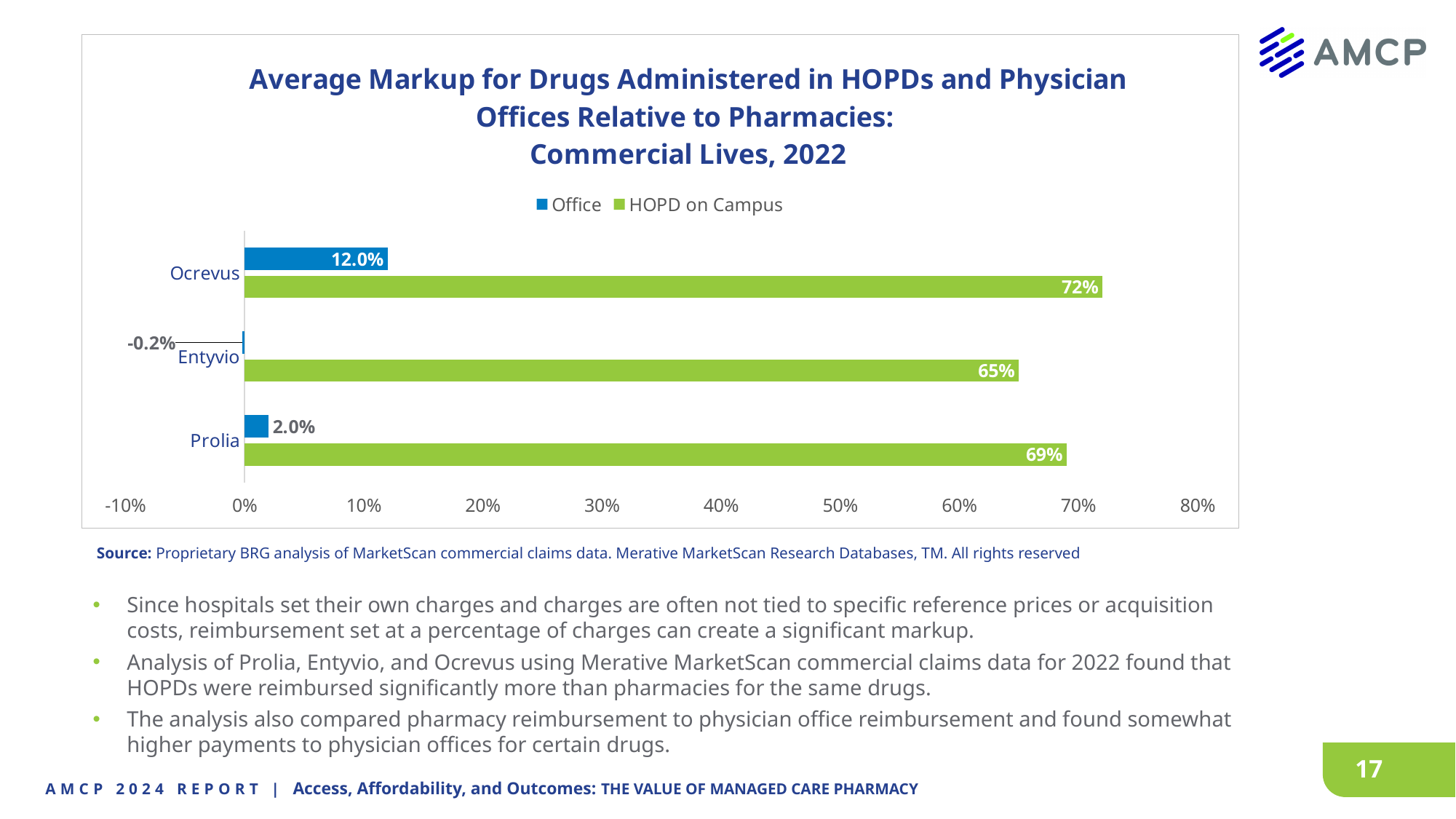
How many series does the legend list? 2 Which is larger for Prolia, the Office markup or the HOPD on Campus markup? HOPD on Campus How many drugs are shown on the chart? 3 What is the HOPD on Campus markup for Ocrevus? 72% Which colour represents the HOPD on Campus series? Green Which drug has the highest HOPD on Campus markup? Ocrevus What is the difference between the HOPD on Campus markup and the Office markup for Ocrevus? 60 percentage points Which drug has the lowest Office markup? Entyvio What is the Office markup for Entyvio? -0.2% What type of chart is shown on the slide? Bar chart What is the Office markup for Prolia? 2.0% What is the HOPD on Campus markup for Entyvio? 65%